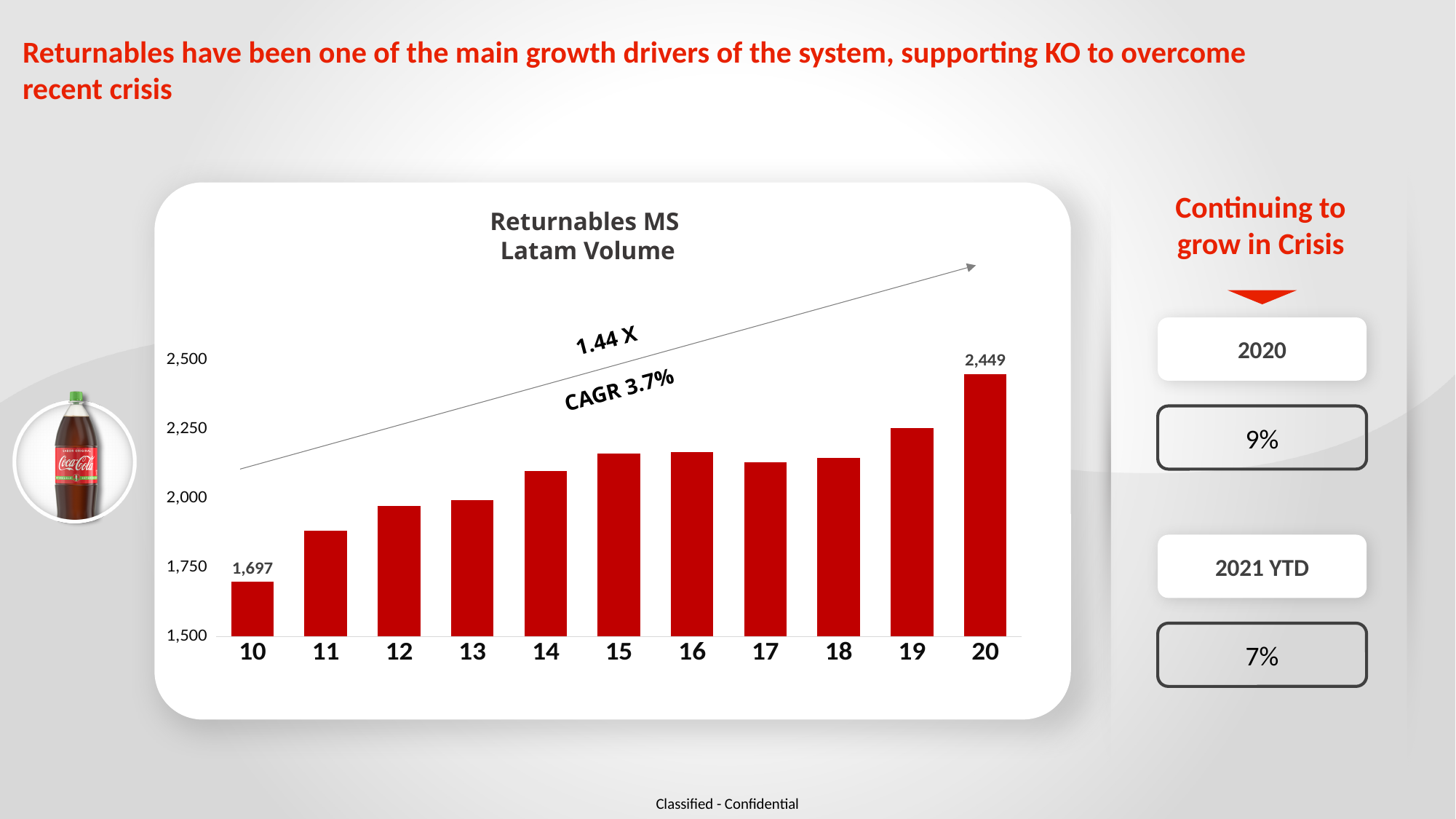
How many years are shown on the x axis of the chart? 11 What CAGR is annotated on the chart? 3.7% Which year has the larger value, 18 or 19? 19 Which year has the highest bar in the chart? 20 Which year has the lowest bar in the chart? 10 What kind of chart is shown on the slide? bar chart What is the value for year 10 in the Returnables MS Latam Volume chart? 1,697 Is the value for year 14 greater or less than 2,000? greater Do the values generally rise or fall from year 10 to year 20? rise What is the difference between the values for year 20 and year 10? 752 Is the value for year 11 greater or less than 2,000? less What is the value for year 20 in the Returnables MS Latam Volume chart? 2,449